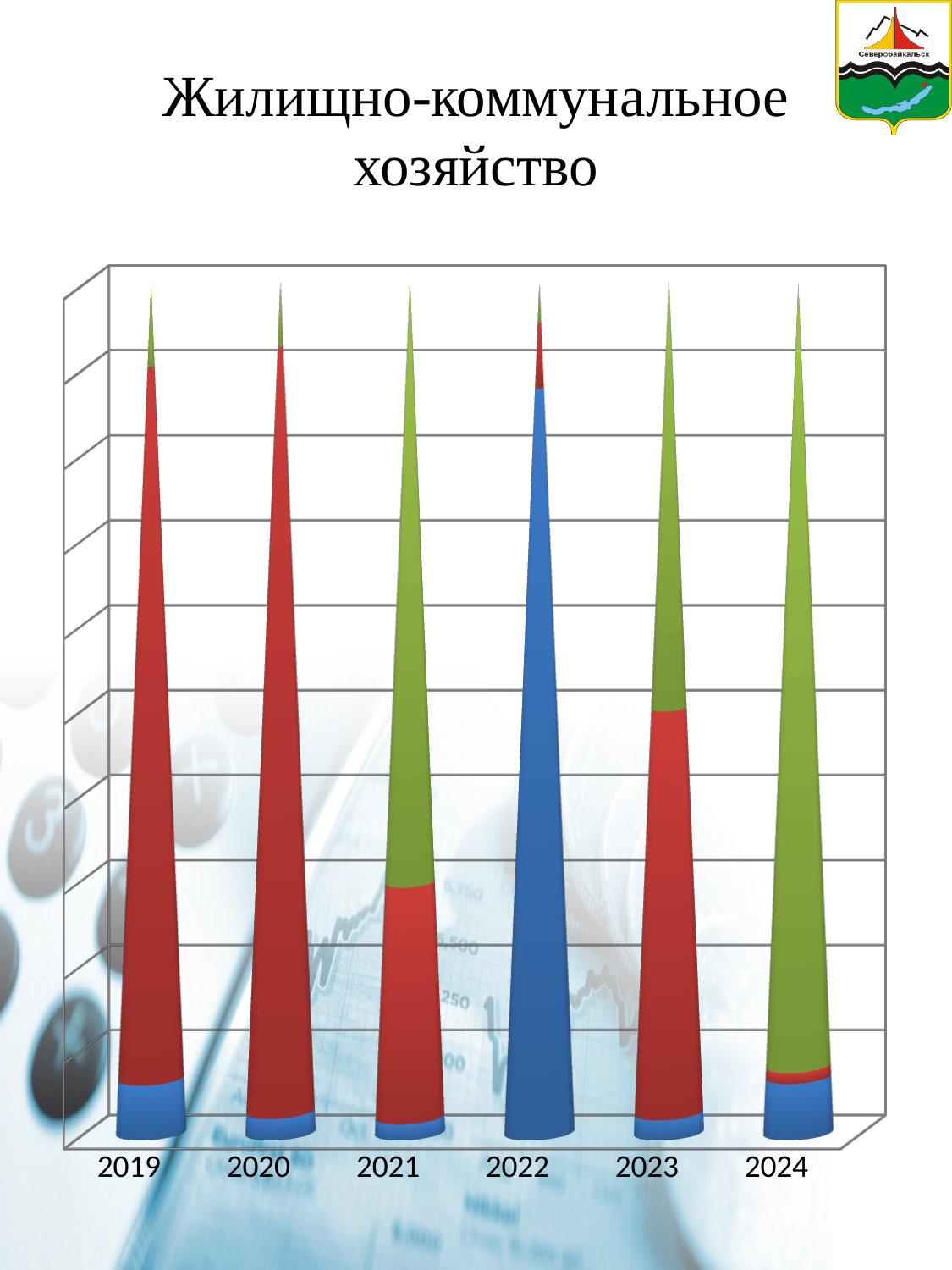
What is the first year shown on the x axis of the chart? 2019 Which year has the largest blue segment in its bar? 2022 Is the green segment larger in 2021 or in 2020? 2021 Is the red segment larger in 2023 or in 2024? 2023 What kind of chart is shown on the slide? bar chart Is the blue segment larger in 2022 or in 2019? 2022 What is the title of the chart on the slide? Жилищно-коммунальное хозяйство How many years are shown on the x axis of the chart? 6 Which year has the largest green segment in its bar? 2024